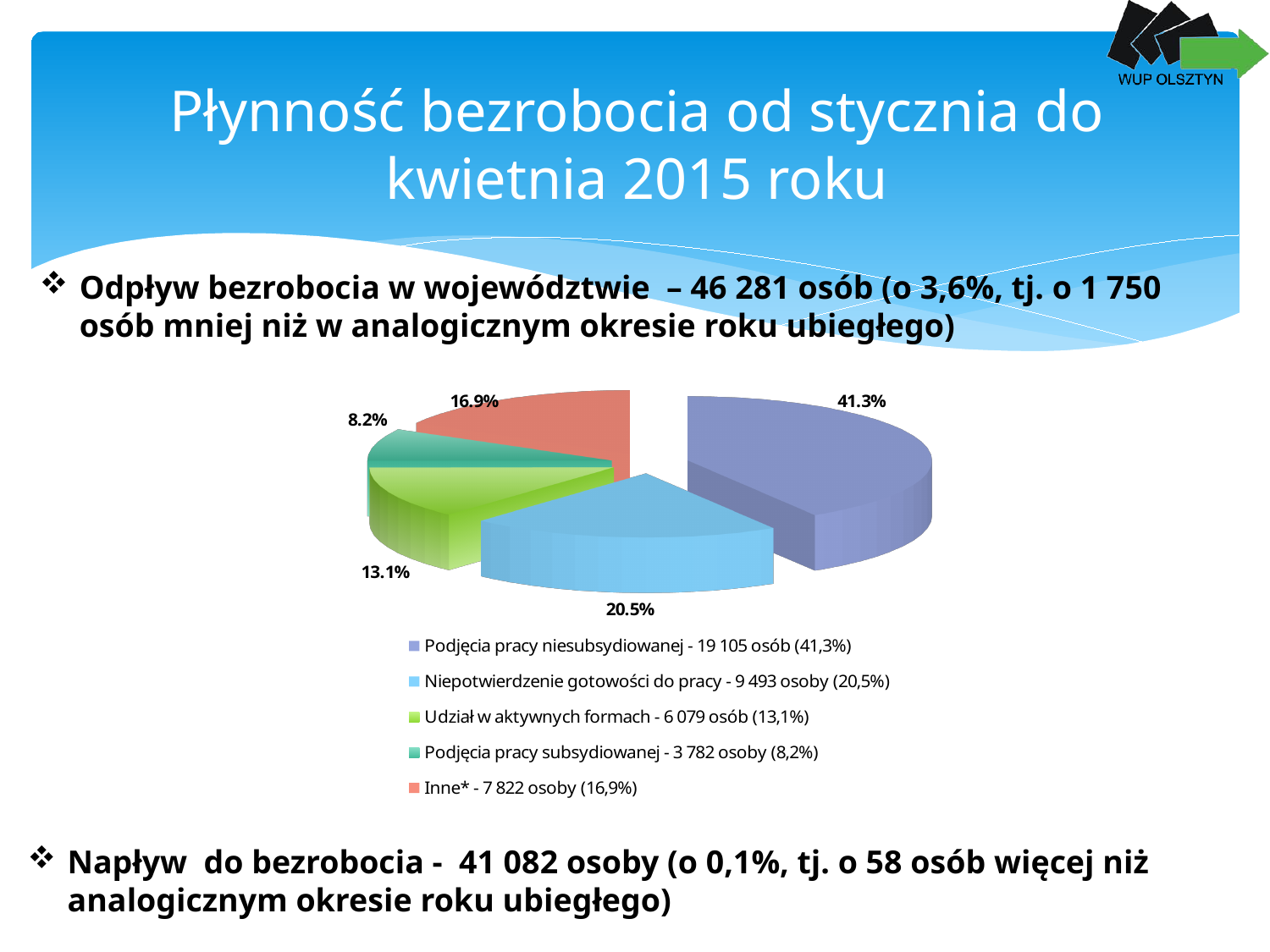
What share of the pie does "Niepotwierdzenie gotowości do pracy" represent? 20.5% What share of the pie does "Inne*" represent? 16.9% Which category has the smallest slice of the pie? Podjęcia pracy subsydiowanej Which category has the largest slice of the pie? Podjęcia pracy niesubsydiowanej Which slice is larger: "Inne*" or "Udział w aktywnych formach"? Inne* What share of the pie does "Podjęcia pracy subsydiowanej" represent? 8.2% What kind of chart is shown on the slide? pie chart According to the legend, how many people does the "Inne*" category represent? 7 822 osoby How many slices does the pie chart have? 5 What is the difference in percentage points between the "Podjęcia pracy niesubsydiowanej" slice and the "Niepotwierdzenie gotowości do pracy" slice? 20.8